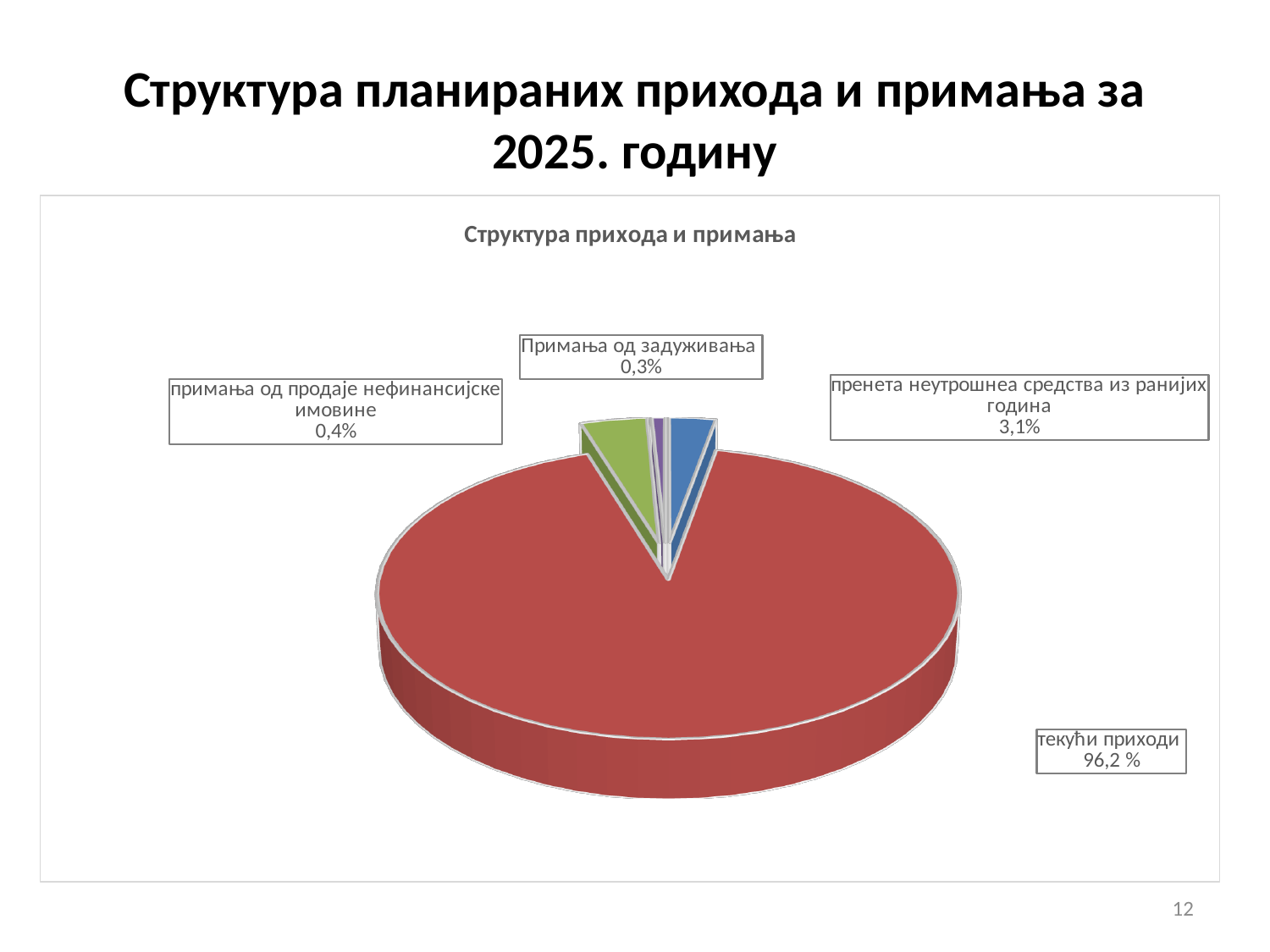
What is the value shown for пренета неутрошнеа средства из ранијих година? 3,1% How many slices does the pie chart have? 4 What is the title of the chart? Структура прихода и примања Which category has the largest slice of the pie? текући приходи What is the value shown for примања од продаје нефинансијске имовине? 0,4% What is the difference in percentage points between пренета неутрошнеа средства из ранијих година and примања од продаје нефинансијске имовине? 2,7 Which category has the smallest slice of the pie? Примања од задуживања What kind of chart is shown on the slide? pie chart What colour is the slice for текући приходи? red Which is larger: примања од продаје нефинансијске имовине or Примања од задуживања? примања од продаје нефинансијске имовине What is the value shown for Примања од задуживања? 0,3% What share of the pie is labelled for текући приходи? 96,2 %